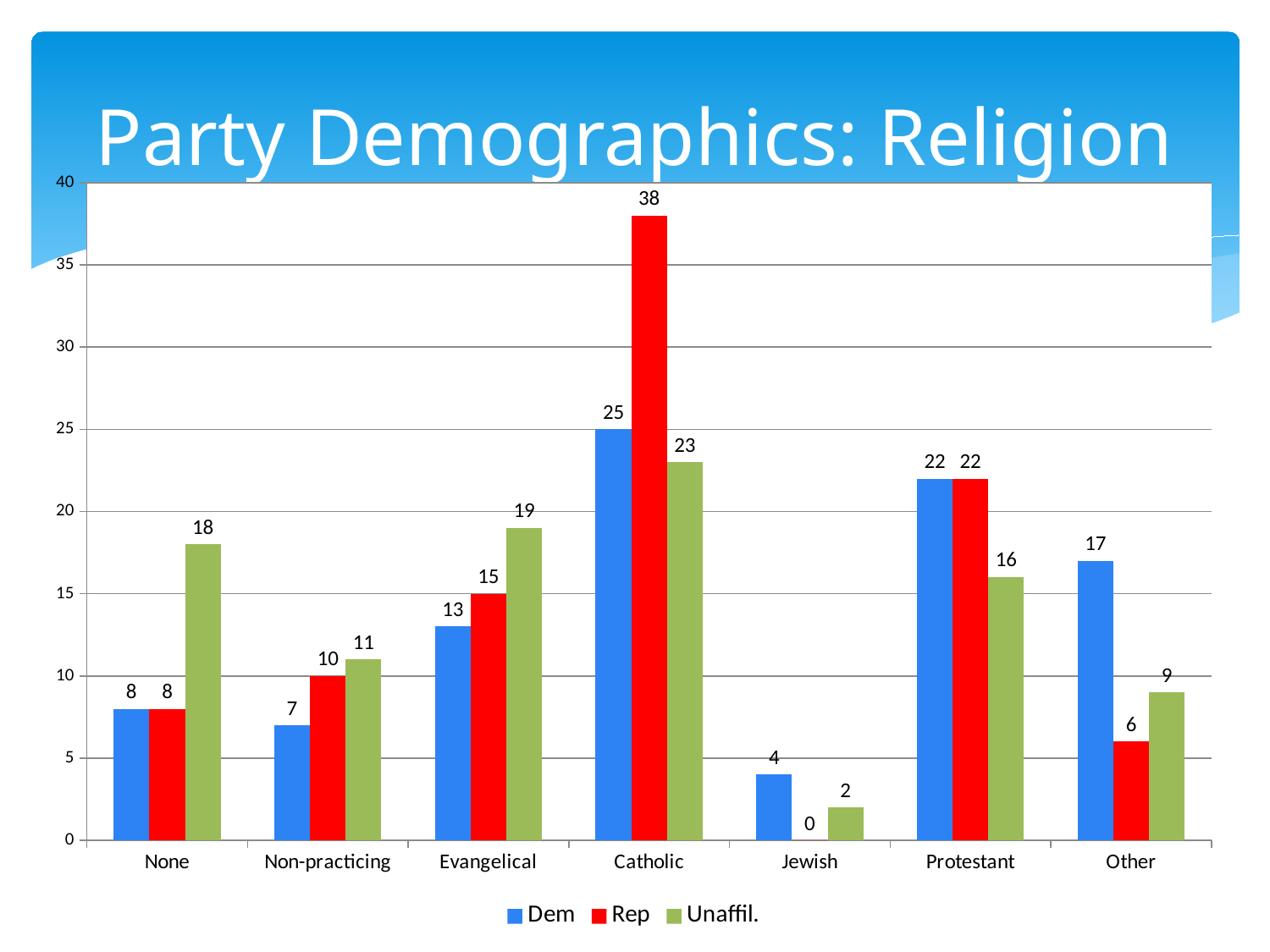
Which is larger for Evangelical, the Dem value or the Unaffil. value? Unaffil. What is the Unaffil. value for None? 18 Which category has the highest Rep value? Catholic What is the Dem value for Other? 17 What is the title of the chart? Party Demographics: Religion How many religion categories are shown on the x axis? 7 How many series does the legend list? 3 What kind of chart is shown on the slide? Bar chart Which category has the lowest Unaffil. value? Jewish What is the Rep value for Jewish? 0 What is the difference between the Rep and Dem values for Catholic? 13 What is the Rep value for Catholic? 38